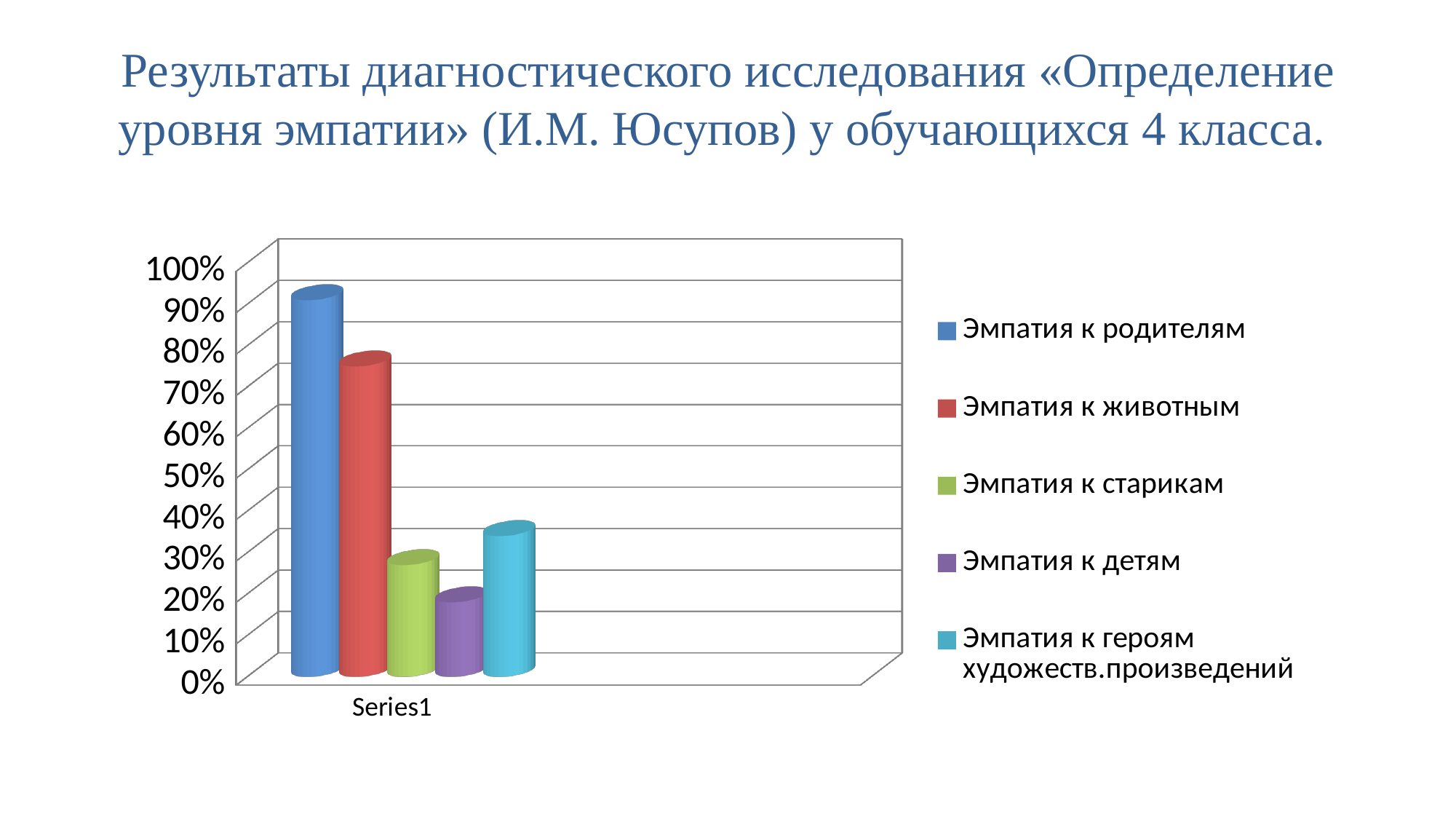
Is the value for Эмпатия к животным greater or less than 60%? greater Which is larger: the value for Эмпатия к старикам or for Эмпатия к героям художеств.произведений? Эмпатия к героям художеств.произведений Is the value for Эмпатия к героям художеств.произведений greater or less than 50%? less Is the value for Эмпатия к детям greater or less than 30%? less Which is larger: the value for Эмпатия к животным or for Эмпатия к родителям? Эмпатия к родителям Which series has the highest bar? Эмпатия к родителям What kind of chart is shown on the slide? bar chart How many series does the legend list? 5 What colour is the bar for Эмпатия к родителям? blue Which series has the lowest bar? Эмпатия к детям